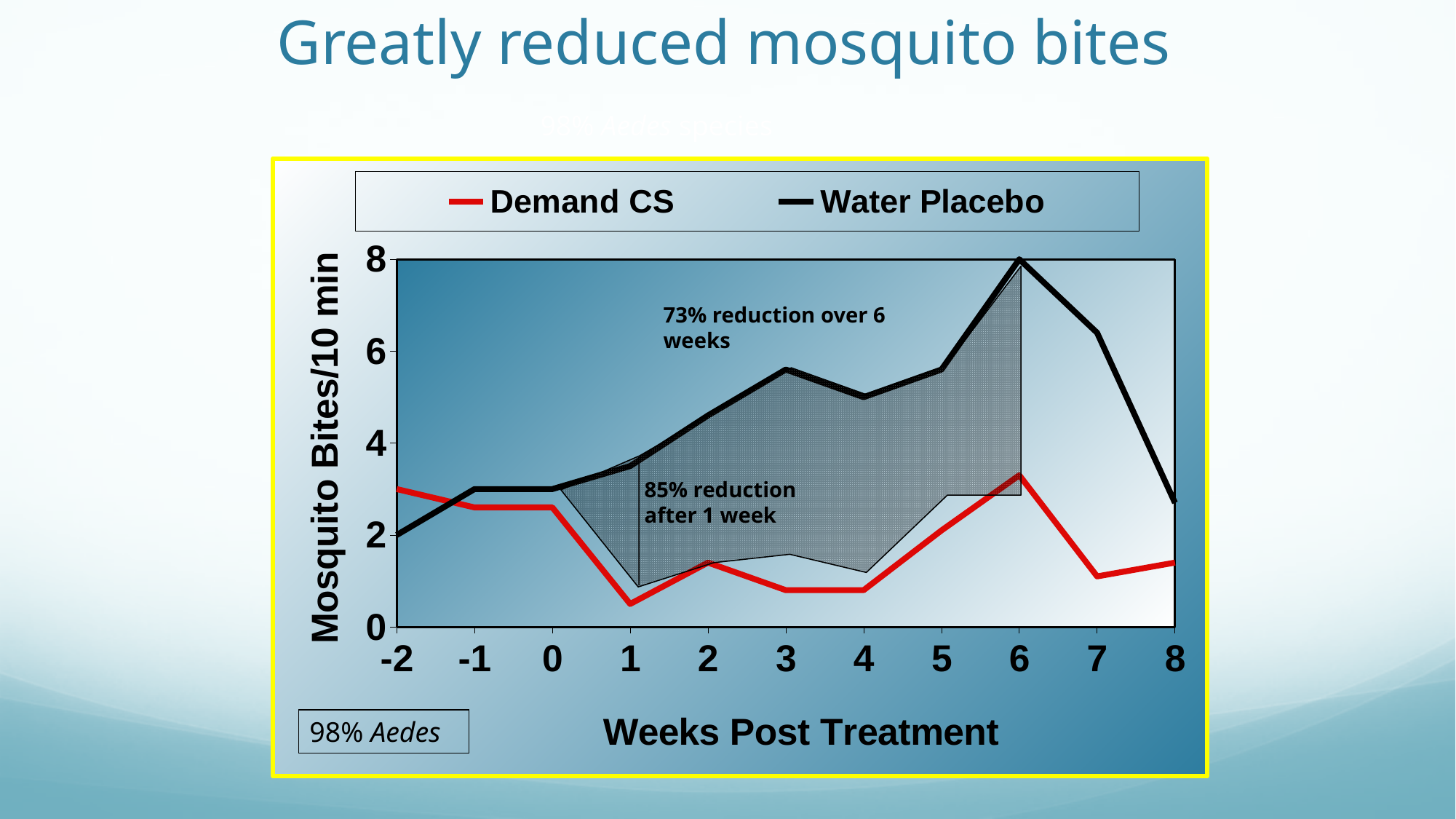
What reduction over 6 weeks is stated in the annotation on the chart? 73% reduction over 6 weeks Is the value for Water Placebo at week 6 greater or less than 6? greater Does the Water Placebo series rise or fall from week 6 to week 8? fall At week 4, which series has the higher value, Demand CS or Water Placebo? Water Placebo At which week does the Water Placebo series reach its highest value? 6 What is the title of the y axis? Mosquito Bites/10 min Is the value for Demand CS at week 1 greater or less than 2? less What kind of chart is shown on the slide? line chart How many week values are marked along the x axis? 11 At which week does the Demand CS series reach its lowest value? 1 How many series does the legend list? 2 At week -2, which series has the higher value, Demand CS or Water Placebo? Demand CS